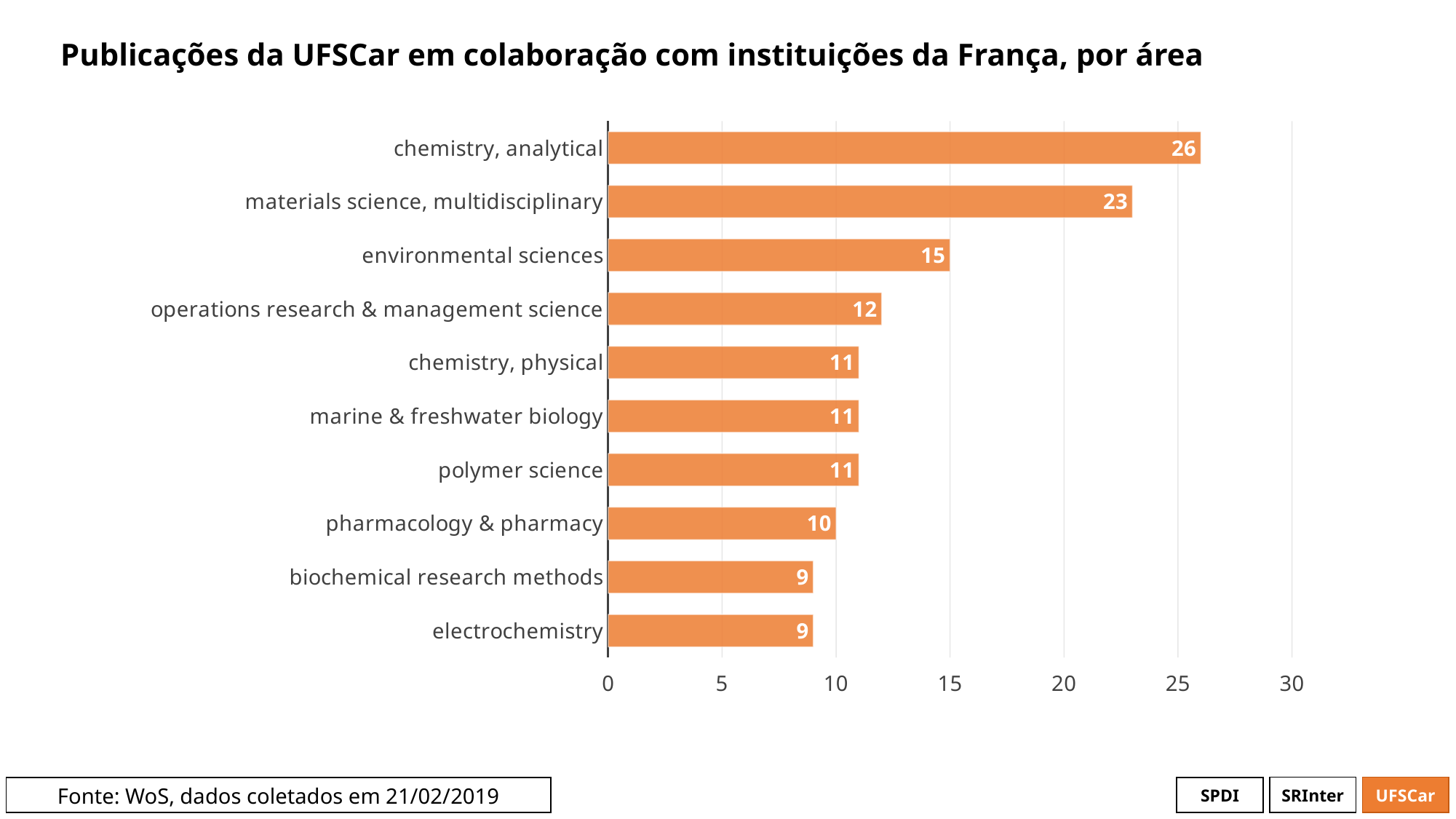
What is the value for chemistry, analytical? 26 What is the difference between environmental sciences and electrochemistry? 6 Which is larger, operations research & management science or polymer science? operations research & management science Is the value for materials science, multidisciplinary greater or less than 20? greater What is the value for environmental sciences? 15 How many areas are shown in the chart? 10 Which area has the highest value? chemistry, analytical What kind of chart is shown on the slide? bar chart What is the source stated at the bottom of the slide? WoS, dados coletados em 21/02/2019 What is the value for pharmacology & pharmacy? 10 What is the difference between chemistry, analytical and materials science, multidisciplinary? 3 What is the title of the chart? Publicações da UFSCar em colaboração com instituições da França, por área